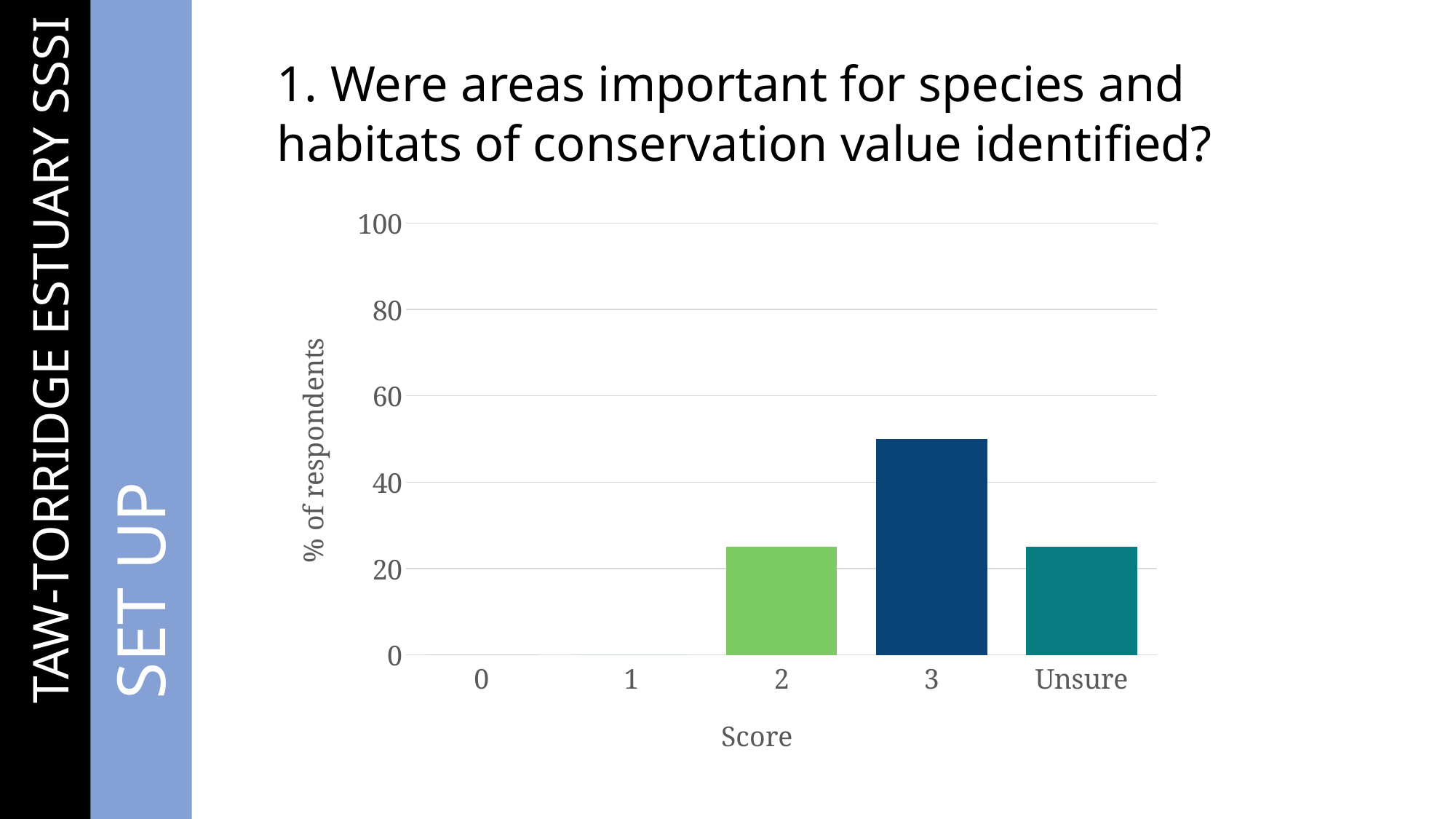
What is the label on the x axis of the chart? Score What is the label on the y axis of the chart? % of respondents Is the value for score 2 greater or less than 40? less What percentage of respondents gave a score of 0? 0 What kind of chart is shown on the slide? bar chart Is the value for score 3 greater or less than 40? greater What percentage of respondents gave a score of 1? 0 Is the value for score 3 greater or less than 60? less Which has a larger percentage of respondents, score 2 or score 3? 3 How many categories are shown on the x axis of the chart? 5 Which score has the highest percentage of respondents? 3